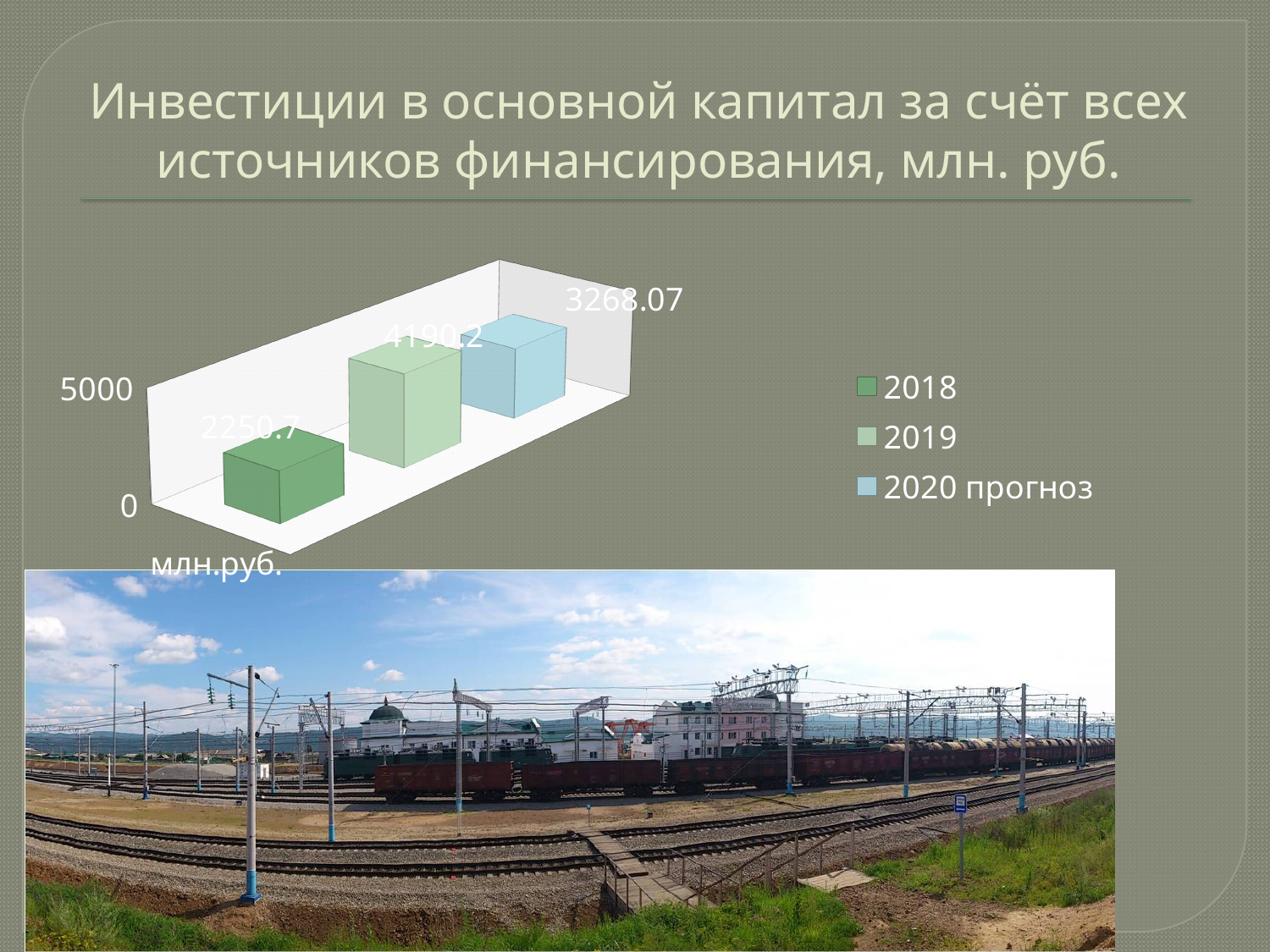
Which is larger, the value for 2020 прогноз or the value for 2018? 2020 прогноз What is the difference between the values for 2019 and 2018? 1939.5 Which year has the highest value? 2019 What is the difference between the values for 2019 and 2020 прогноз? 922.13 What is the value for 2018? 2250.7 Which year has the lowest value? 2018 Is the value for 2019 greater or less than 5000? less What is the value for 2019? 4190.2 What is the value for 2020 прогноз? 3268.07 How many series does the legend list? 3 What kind of chart is shown on the slide? bar chart What unit is given in the chart title? млн. руб.